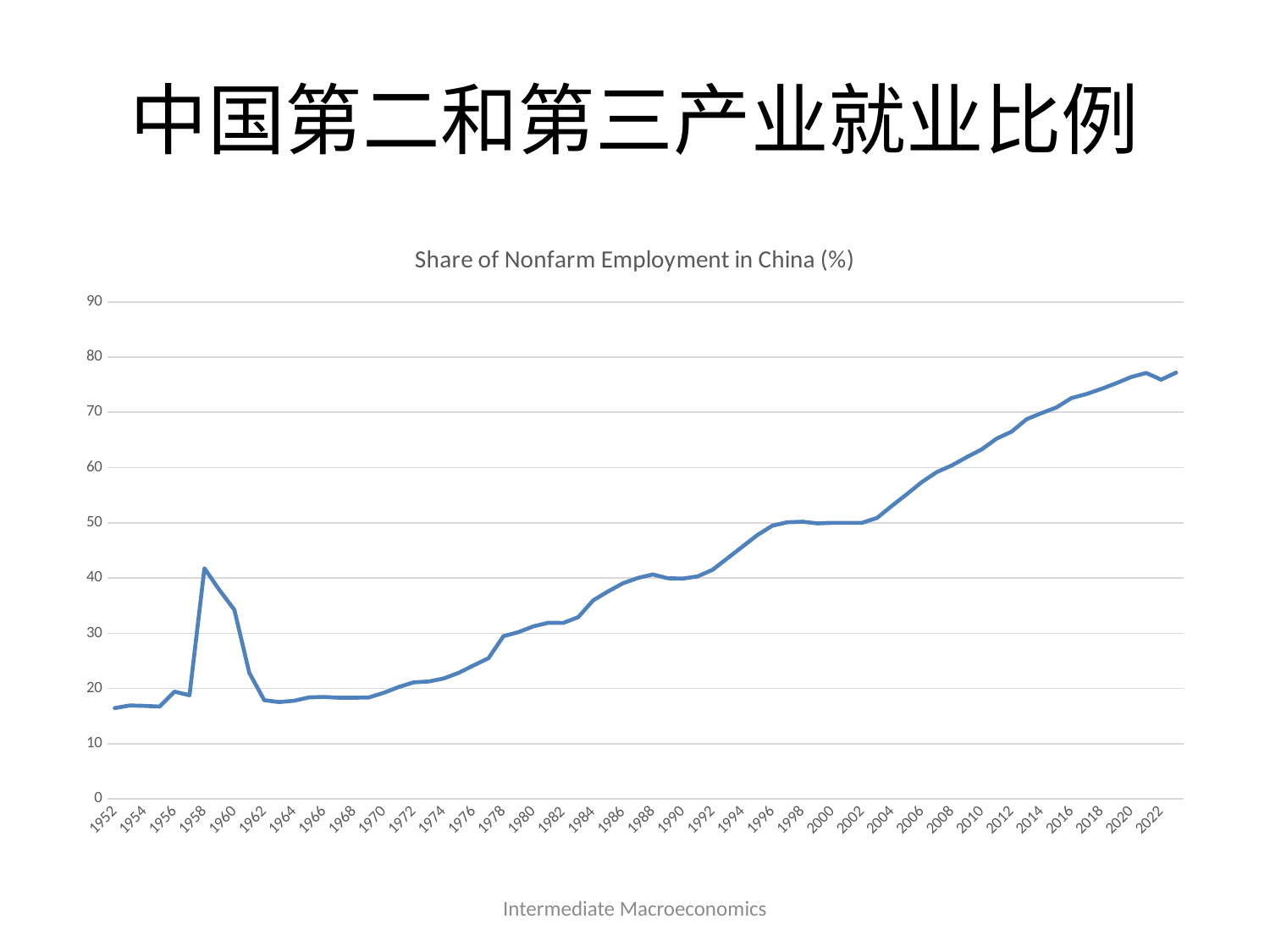
Is the value for 2022 greater or less than 70? greater Is the value for 2012 greater or less than 60? greater What kind of chart is shown on the slide? line chart Which year has the larger value, 1952 or 2022? 2022 Overall, does the share of nonfarm employment rise or fall from 1952 to 2022? rise What is the highest value shown on the vertical axis? 90 What is the title of the chart? Share of Nonfarm Employment in China (%) Is the value for 1952 greater or less than 20? less Which year has the larger value, 1958 or 1962? 1958